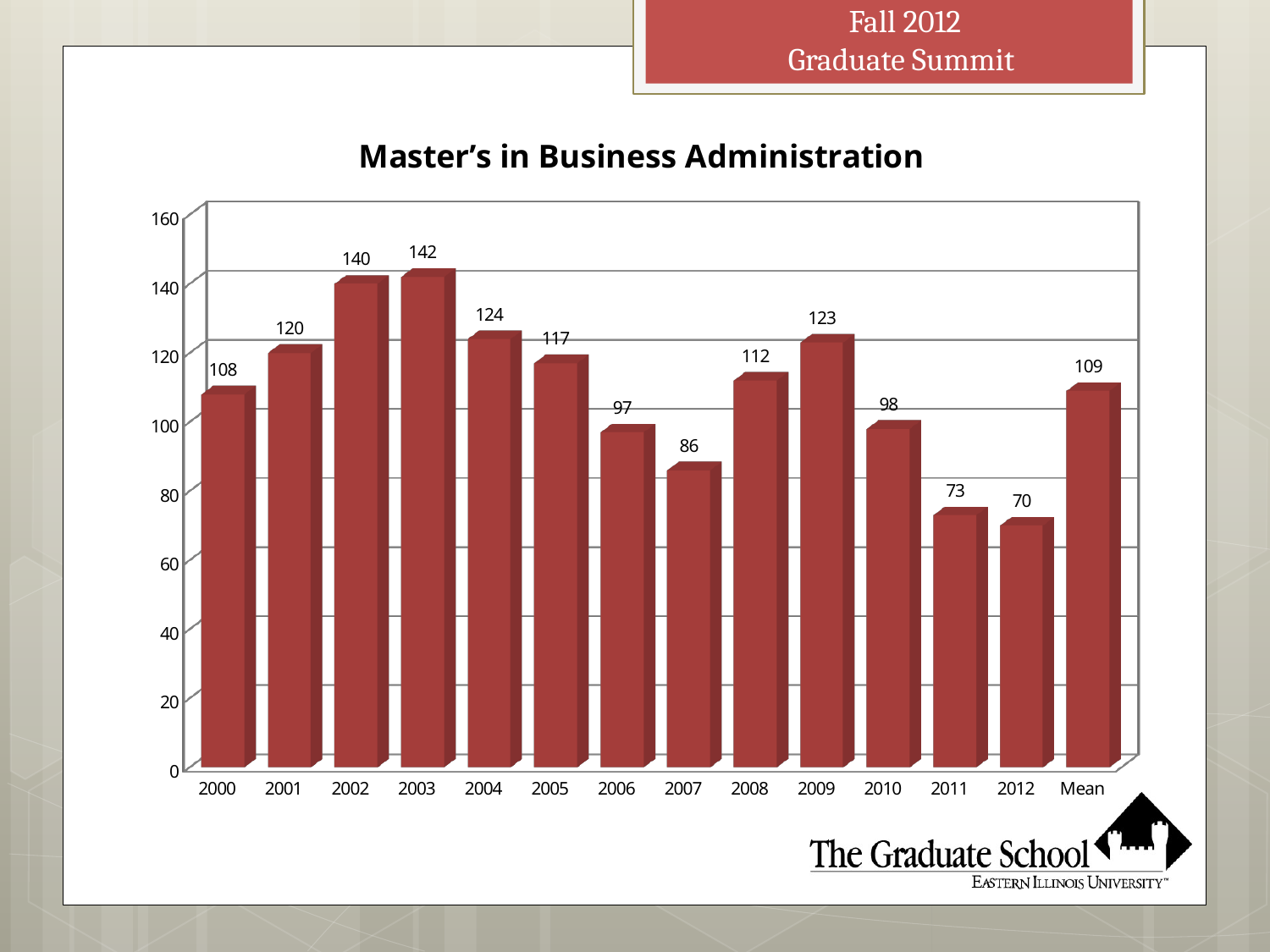
What kind of chart is shown on the slide? Bar chart What is the value for 2007? 86 What is the title of the chart? Master's in Business Administration What is the value shown for Mean? 109 Do the values rise or fall from 2009 to 2012? Fall What is the value for 2003? 142 Which year has the lowest value? 2012 What is the difference between the values for 2002 and 2011? 67 Which year has the highest value? 2003 How many bars are shown in the chart? 14 Is the value for 2008 greater or less than 100? greater Which is larger, the value for 2004 or the value for 2009? 2004